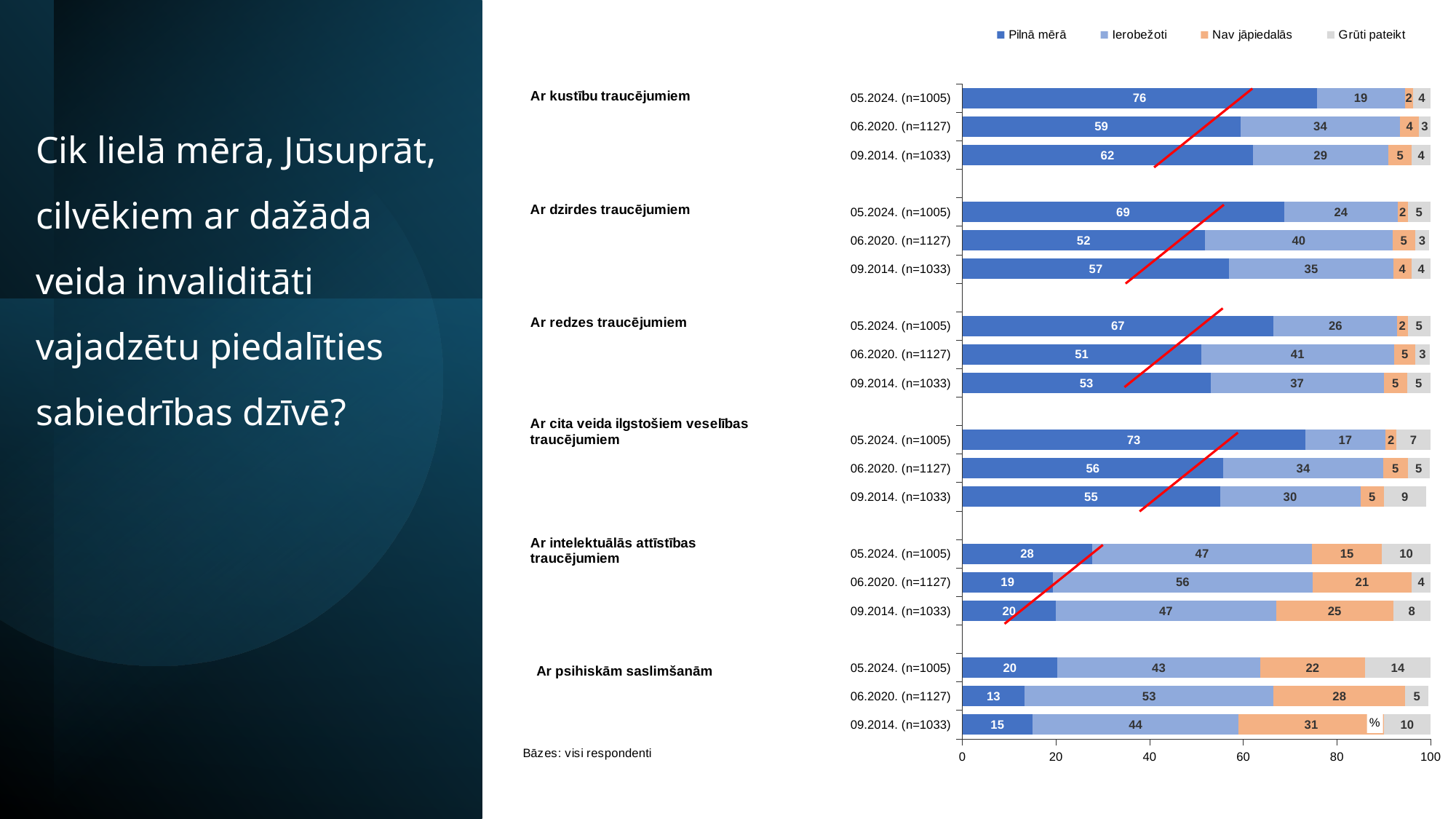
Which legend entry is shown in orange? Nav jāpiedalās What is the total of the stacked bar for "Ar cita veida ilgstošiem veselības traucējumiem" in 05.2024. (n=1005)? 99 What is the "Pilnā mērā" value for "Ar kustību traucējumiem" in 05.2024. (n=1005)? 76 Which group has the highest "Pilnā mērā" value in 05.2024. (n=1005)? Ar kustību traucējumiem Which group has the lowest "Pilnā mērā" value in 06.2020. (n=1127)? Ar psihiskām saslimšanām How many bars are plotted in the chart? 18 Which is larger for "Ar redzes traucējumiem" in 09.2014. (n=1033): the "Pilnā mērā" value or the "Ierobežoti" value? Pilnā mērā How many series does the legend list? 4 What is the "Ierobežoti" value for "Ar intelektuālās attīstības traucējumiem" in 06.2020. (n=1127)? 56 What is the "Nav jāpiedalās" value for "Ar psihiskām saslimšanām" in 09.2014. (n=1033)? 31 What kind of chart is shown on the slide? Stacked bar chart What is the difference between the "Pilnā mērā" values for "Ar dzirdes traucējumiem" in 05.2024. (n=1005) and 06.2020. (n=1127)? 17